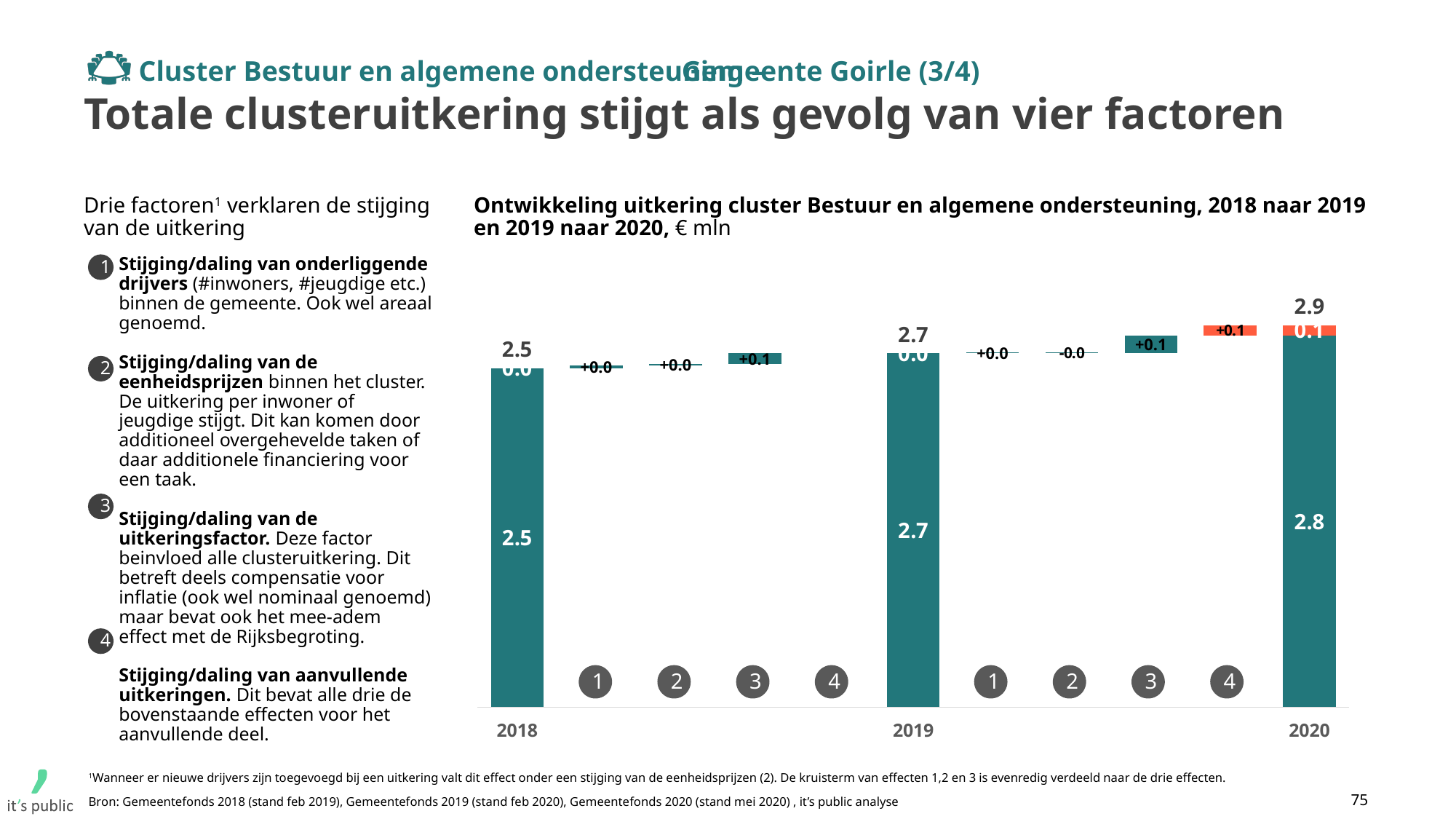
By how much does the total uitkering increase from 2018 to 2020? 0.4 What is the value of the teal (lower) segment of the 2020 bar? 2.8 Which year has the highest total uitkering? 2020 What is the total uitkering shown for 2020? 2.9 Which year has the lowest total uitkering? 2018 What is the value of factor 4 in the step from 2019 to 2020? +0.1 What is the total uitkering shown for 2019? 2.7 What is the value of factor 3 in the step from 2018 to 2019? +0.1 In what unit are the values in the chart expressed? € mln What is the value of the orange segment on top of the 2020 bar? 0.1 Do the yearly totals rise or fall from 2018 to 2020? rise What is the total uitkering shown for 2018? 2.5